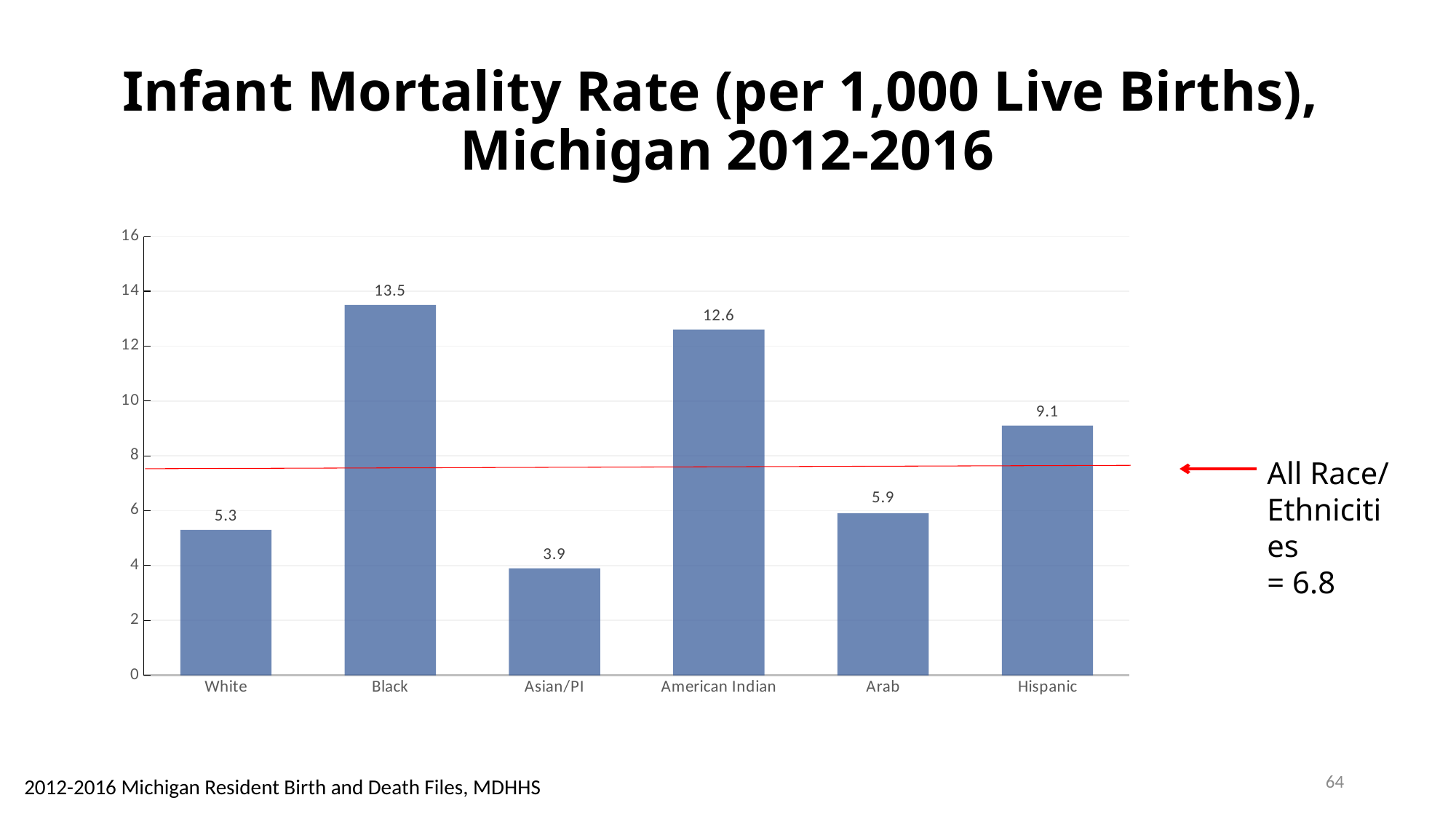
Which race/ethnicity has the lowest infant mortality rate? Asian/PI Which has a higher infant mortality rate, Arab or White? Arab What is the difference between the infant mortality rates for American Indian and Hispanic infants? 3.5 What is the difference between the infant mortality rates for Black and White infants? 8.2 How many race/ethnicity categories are shown in the chart? 6 Which race/ethnicity has the highest infant mortality rate? Black What value does the red horizontal line labelled 'All Race/Ethnicities' represent? 6.8 What is the infant mortality rate for Hispanic infants? 9.1 What is the infant mortality rate for Asian/PI infants? 3.9 What kind of chart is shown on the slide? bar chart What is the infant mortality rate for Black infants? 13.5 Is the infant mortality rate for American Indian infants greater or less than 12? greater